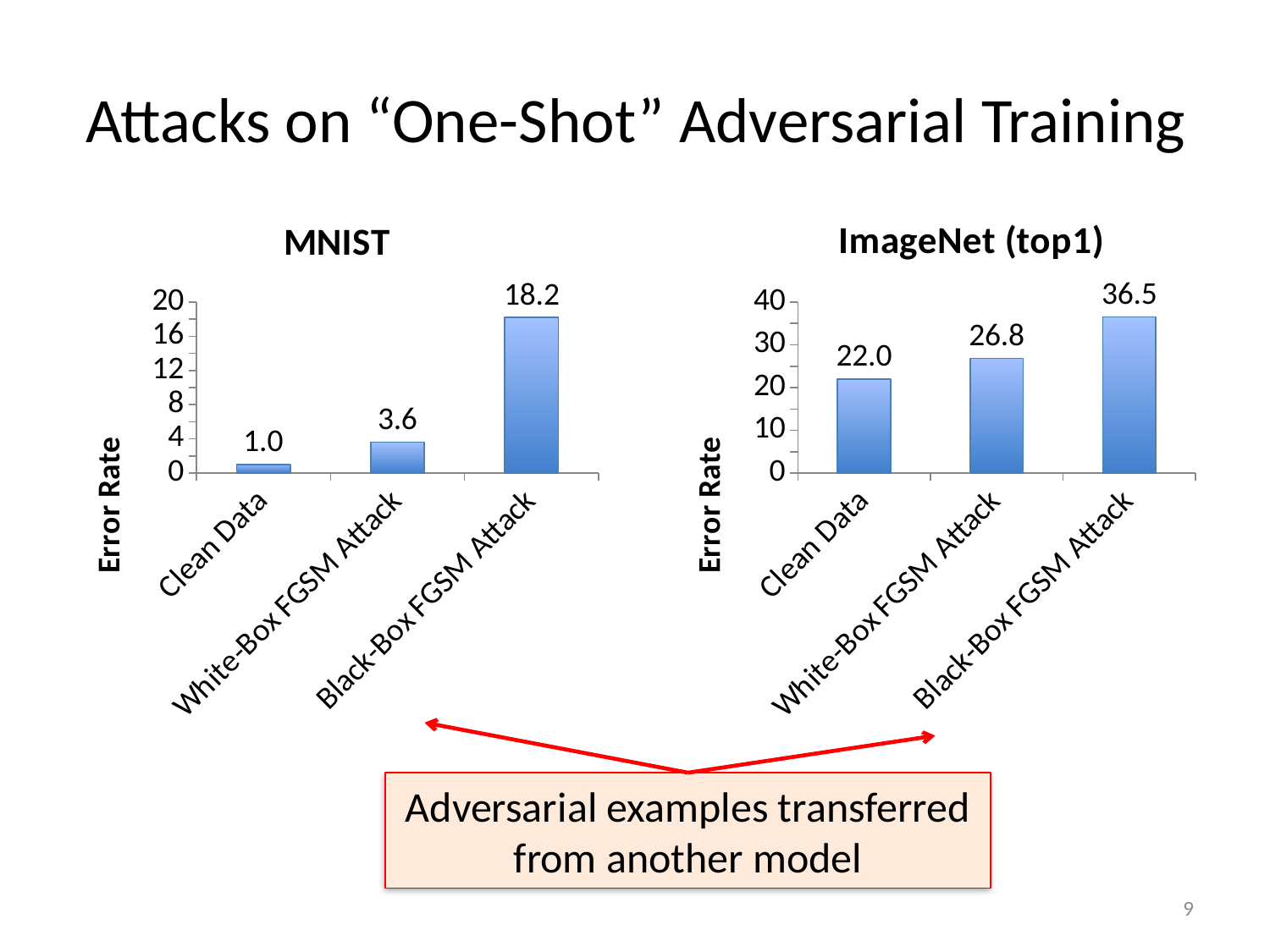
In the ImageNet (top1) chart, what is the error rate for Clean Data? 22.0 How many categories are shown in the MNIST chart? 3 In the ImageNet (top1) chart, which category has the highest error rate? Black-Box FGSM Attack In the MNIST chart, which category has the lowest error rate? Clean Data In the MNIST chart, what is the error rate for Black-Box FGSM Attack? 18.2 In the ImageNet (top1) chart, what is the difference between the error rates for Black-Box FGSM Attack and Clean Data? 14.5 In the ImageNet (top1) chart, is the error rate for White-Box FGSM Attack greater or less than 30? less What kind of chart is the ImageNet (top1) chart? bar chart What is the y-axis label of the MNIST chart? Error Rate In the MNIST chart, which has a larger error rate, White-Box FGSM Attack or Clean Data? White-Box FGSM Attack In the MNIST chart, what is the difference between the error rates for Black-Box FGSM Attack and White-Box FGSM Attack? 14.6 In the ImageNet (top1) chart, what is the error rate for White-Box FGSM Attack? 26.8